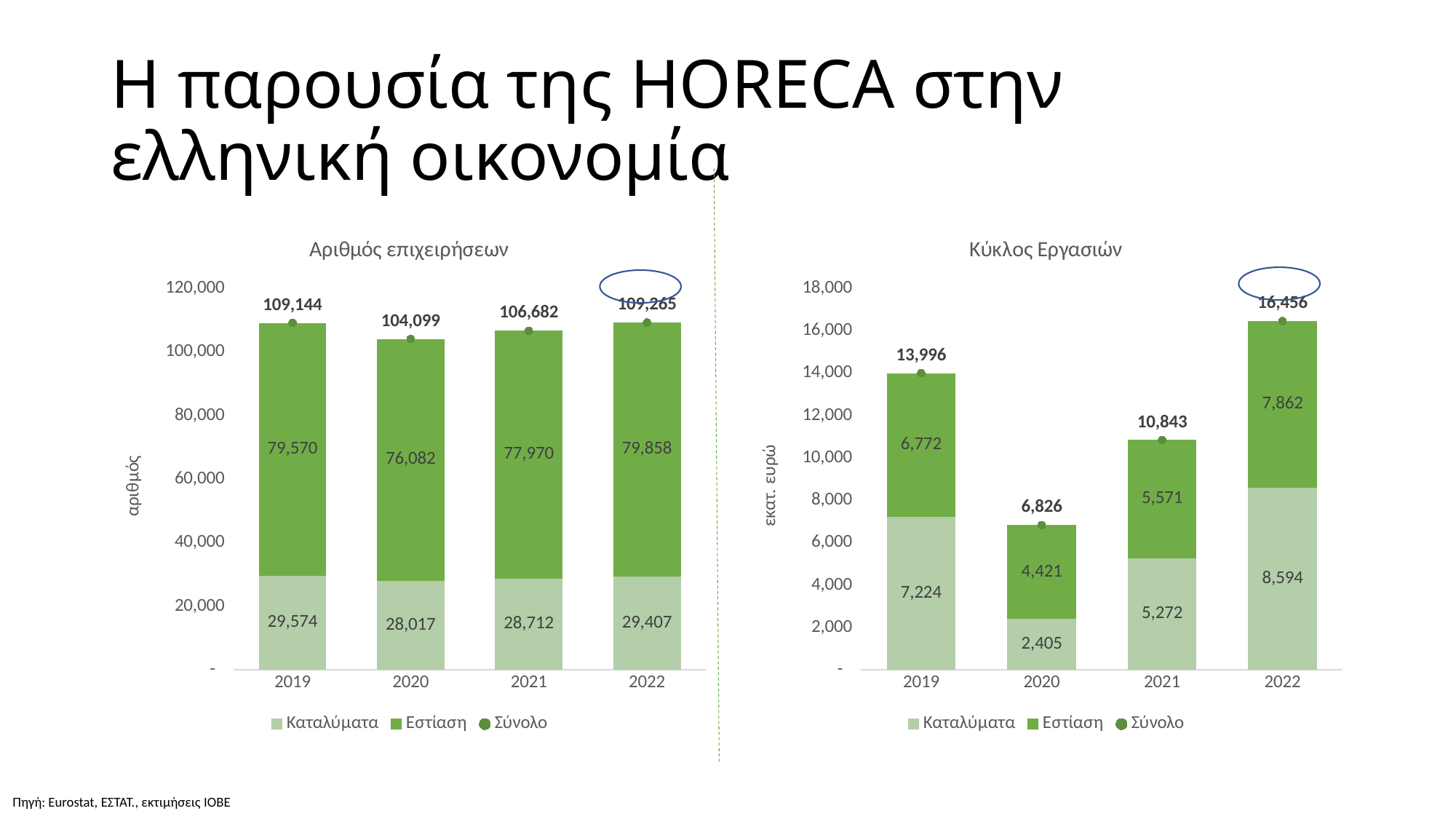
In the 'Αριθμός επιχειρήσεων' chart, what is the difference between the Σύνολο for 2022 and 2019? 121 In the 'Κύκλος Εργασιών' chart, what is the difference between Εστίαση in 2022 and Εστίαση in 2020? 3,441 How many years are shown on the x axis of the 'Αριθμός επιχειρήσεων' chart? 4 In the 'Κύκλος Εργασιών' chart, which year has the highest Σύνολο? 2022 In the 'Αριθμός επιχειρήσεων' chart, what is the value of Εστίαση for 2021? 77,970 In the 'Κύκλος Εργασιών' chart, what is the Σύνολο for 2021? 10,843 What type of chart is the 'Κύκλος Εργασιών' chart? Stacked bar chart In the 'Αριθμός επιχειρήσεων' chart, what is the value of Καταλύματα for 2020? 28,017 How many entries does the legend of the 'Κύκλος Εργασιών' chart list? 3 In the 'Κύκλος Εργασιών' chart, what is the value of Καταλύματα for 2022? 8,594 In the 'Αριθμός επιχειρήσεων' chart, which year has the lowest Σύνολο? 2020 In the 'Κύκλος Εργασιών' chart, which is larger for 2019: Καταλύματα or Εστίαση? Καταλύματα